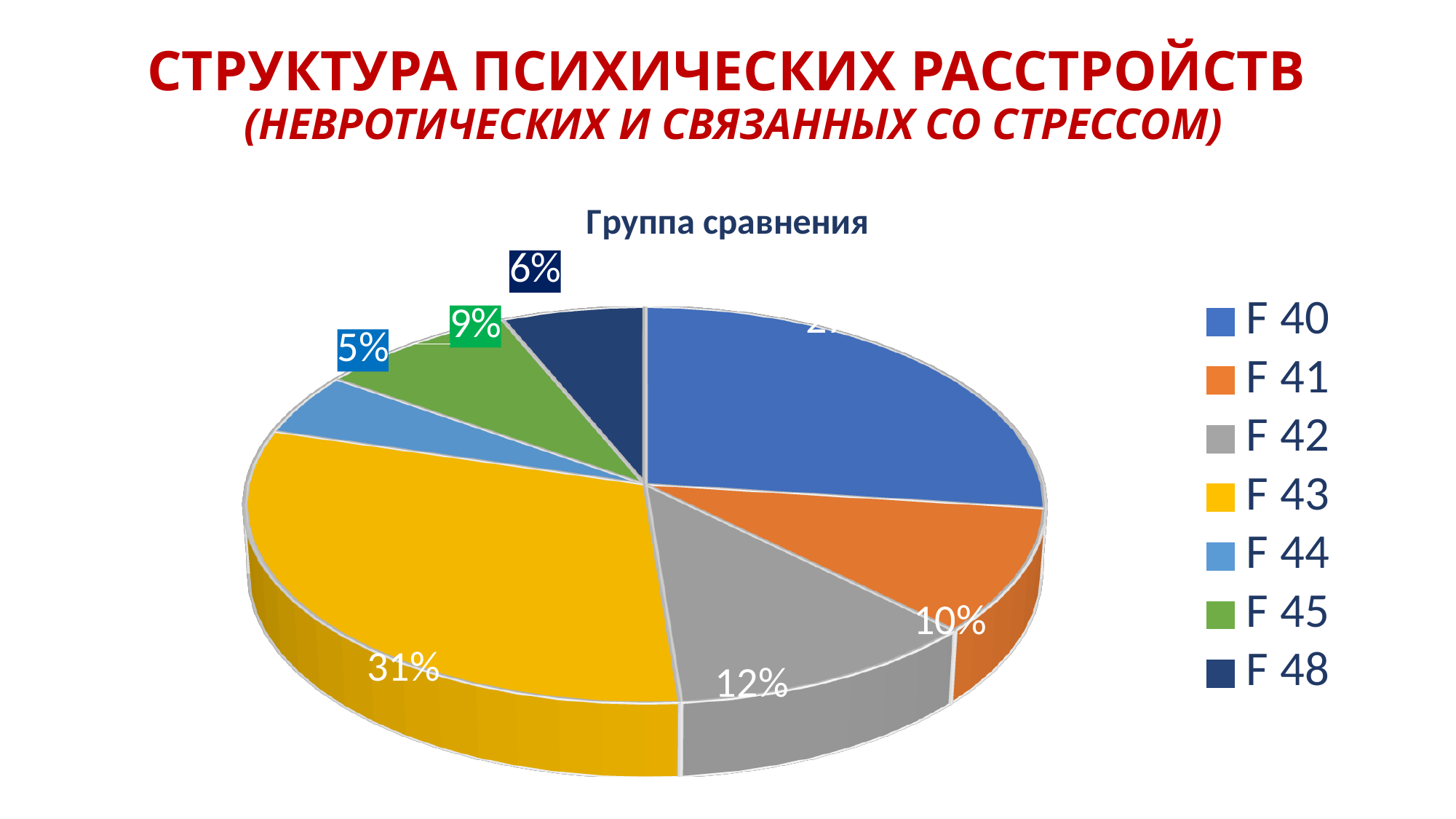
What is the value shown for F 48? 6% What is the value shown for F 45? 9% What is the title of the chart? Группа сравнения What kind of chart is shown on the slide? Pie chart What is the value shown for F 44? 5% What is the value shown for F 41? 10% Which category has the smallest slice of the pie? F 44 Which category has the largest slice of the pie? F 43 What share of the pie does F 43 have? 31% By how many percentage points does F 43 exceed F 42? 19 What is the value shown for F 42? 12% How many categories does the legend list? 7